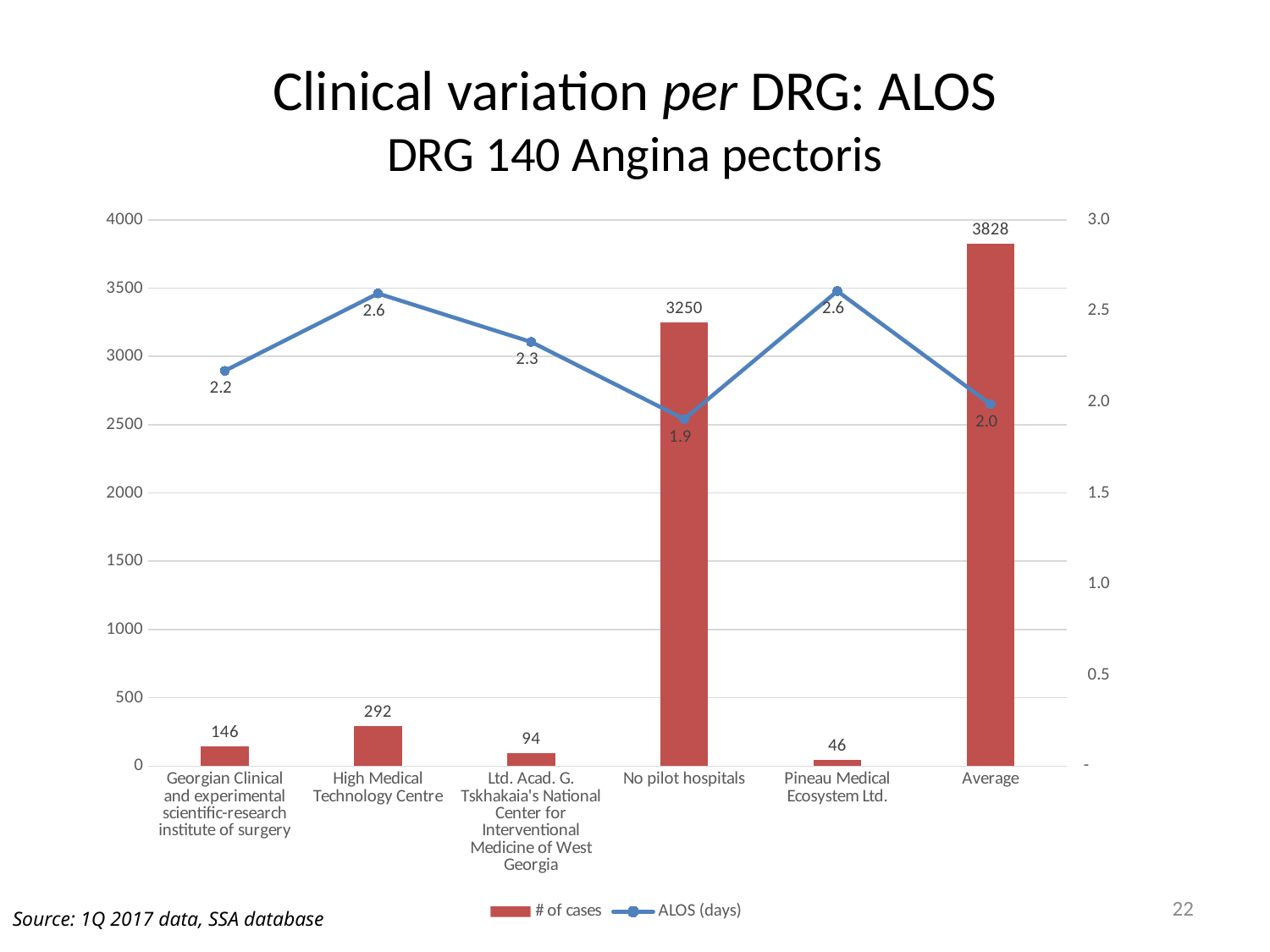
How many series does the legend list? 2 Which category has the lowest ALOS (days)? No pilot hospitals What is the ALOS (days) value for the Average category? 2.0 Which category has the lowest number of cases? Pineau Medical Ecosystem Ltd. What is the number of cases for Pineau Medical Ecosystem Ltd.? 46 Which has more cases, Georgian Clinical and experimental scientific-research institute of surgery or High Medical Technology Centre? High Medical Technology Centre Which category has the highest number of cases? Average How many cases are shown for High Medical Technology Centre? 292 What is the ALOS (days) value for No pilot hospitals? 1.9 What series is plotted as a line in the chart? ALOS (days) What is the difference in number of cases between Average and No pilot hospitals? 578 How many categories are shown on the x axis? 6